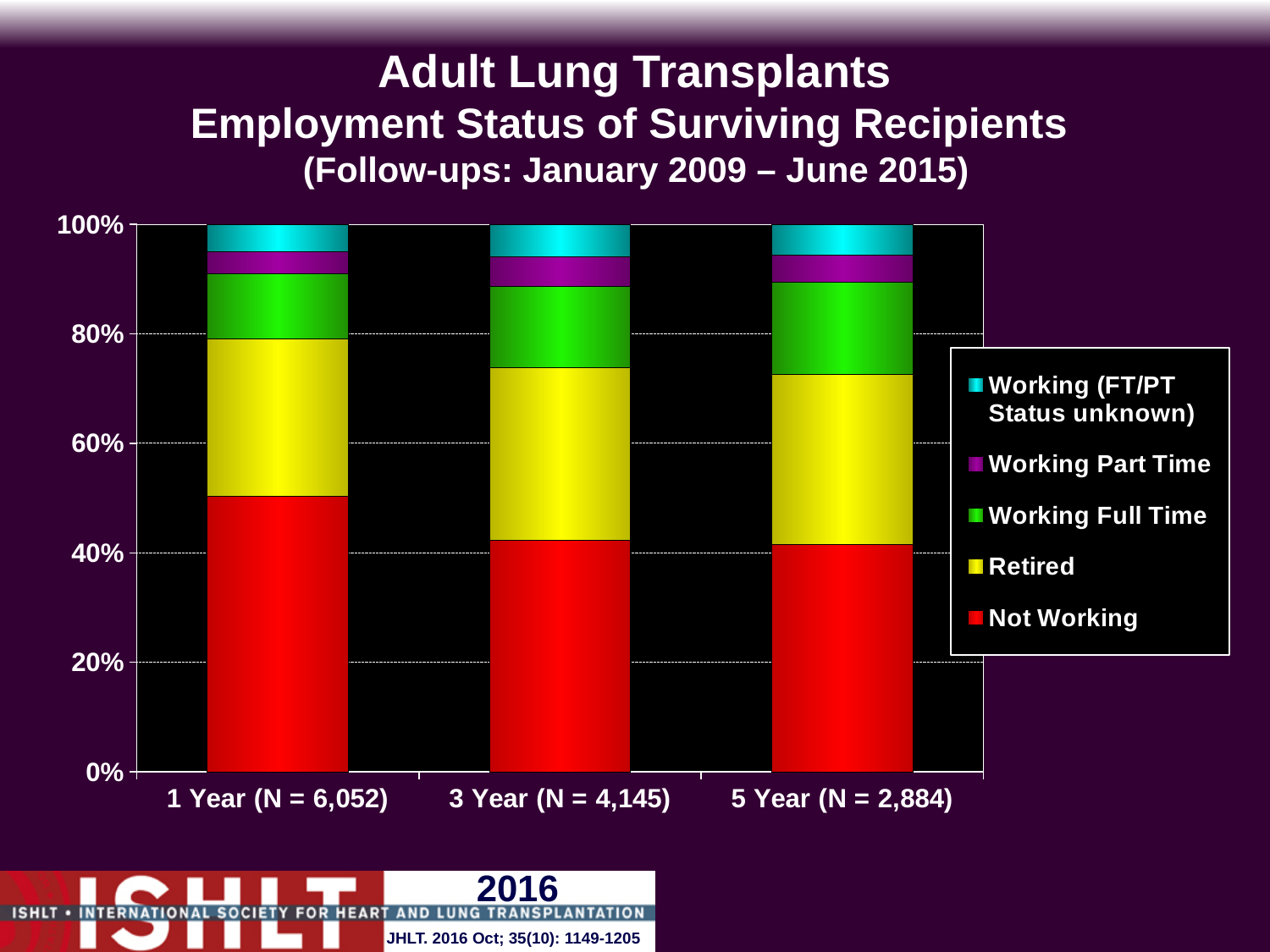
Which follow-up time point has the largest Not Working share? 1 Year (N = 6,052) What does each stacked bar total? 100% Is the Not Working share at 1 Year (N = 6,052) greater or less than 40%? greater Which colour represents Retired in the legend? Yellow What kind of chart is shown on the slide? Stacked bar chart How many follow-up time points (categories) are shown on the x axis? 3 Is the Not Working share at 1 Year larger or smaller than at 3 Year? Larger What is the N shown for the 3 Year follow-up category? 4,145 Is the Not Working share at 5 Year (N = 2,884) greater or less than 60%? less How many series does the legend list? 5 Which follow-up time point has the largest Working Full Time share? 5 Year (N = 2,884) Does the Not Working share rise or fall from 1 Year to 5 Year? Fall